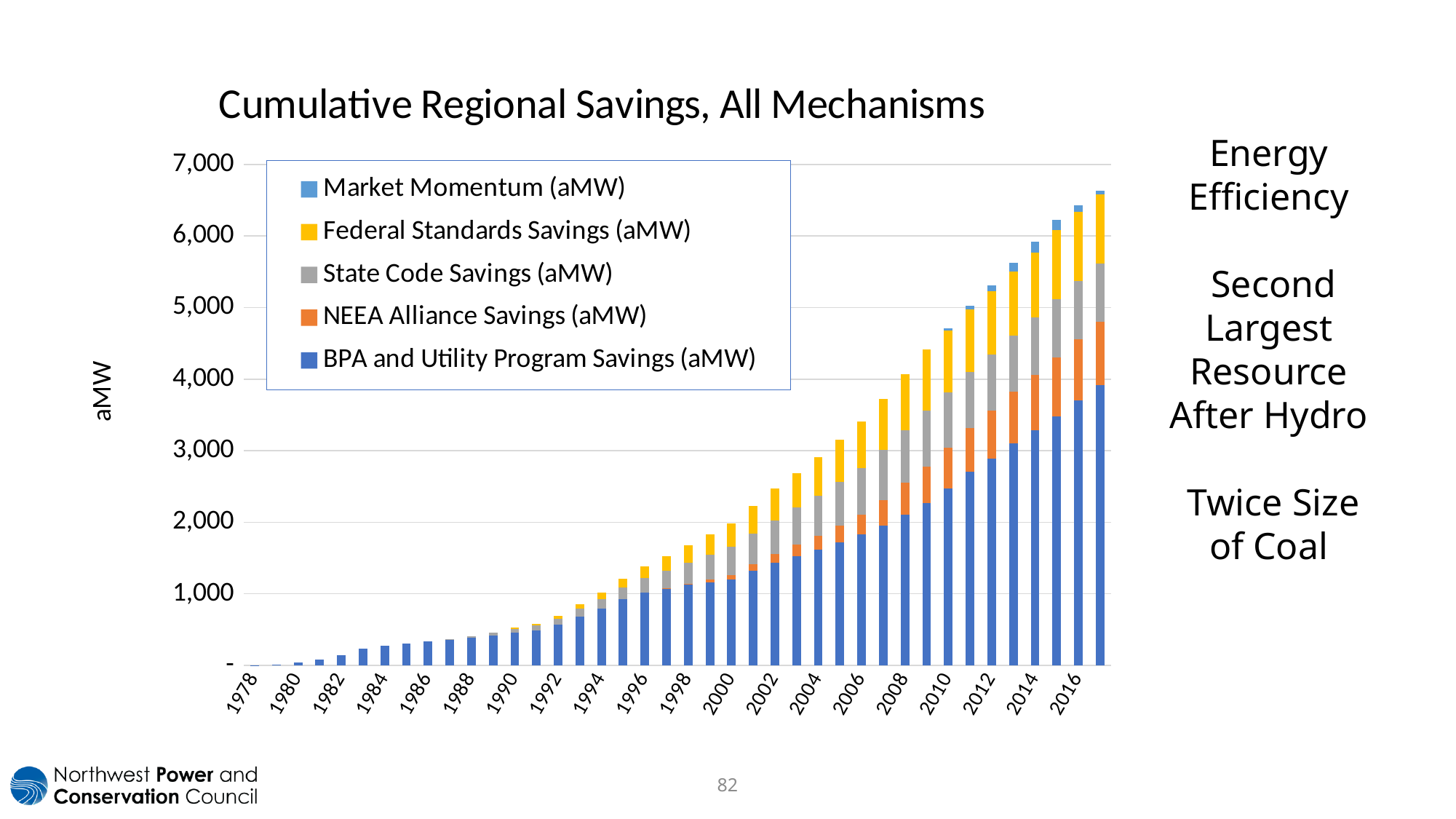
Is the total stacked value for 1990 greater or less than 1,000? less Which year has the highest total cumulative savings, 1996 or 2008? 2008 Do the total cumulative savings rise or fall from 1978 to 2016? Rise Which series is shown in yellow in the legend? Federal Standards Savings (aMW) What is the title of the chart? Cumulative Regional Savings, All Mechanisms Is the total stacked value for 2010 greater or less than 4,000? greater Is the total stacked value for 2016 greater or less than 6,000? greater How many series does the legend list? 5 What kind of chart is shown on the slide? Stacked bar chart